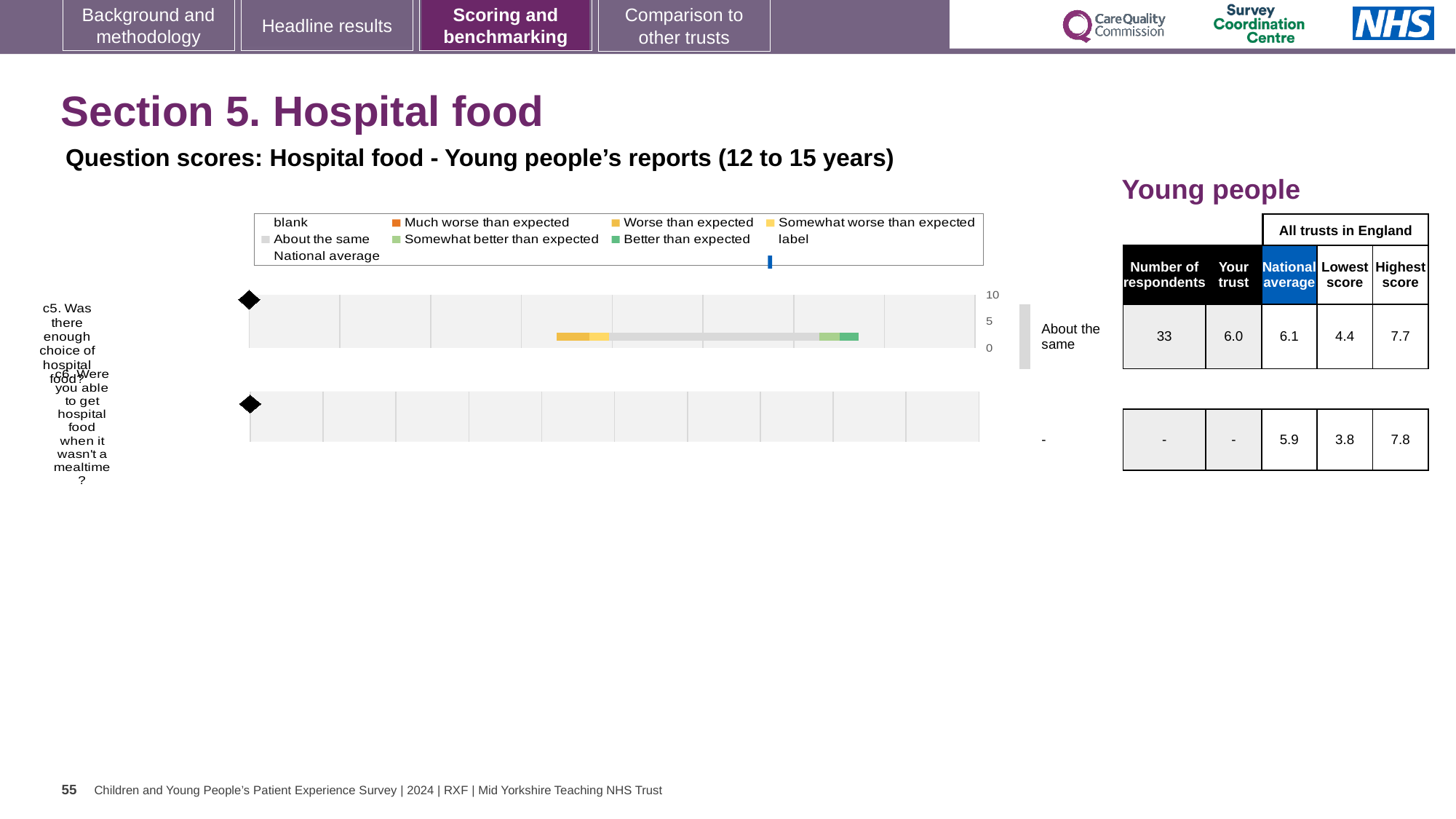
What benchmark category is shown next to the chart for question c5? About the same In the table beside the chart, what is the 'Your trust' score for question c5? 6.0 What is the label of the first question plotted on the chart? c5. Was there enough choice of hospital food? What kind of chart is shown on the slide? bar chart What is the highest value shown on the chart's numeric axis? 10 In the table beside the chart, what is the national average for question c5? 6.1 In the table beside the chart, what is the national average for question c6? 5.9 In the table beside the chart, which is larger for question c5: the 'Your trust' score or the national average? national average In the table beside the chart, what is the difference between the highest score and the lowest score for question c5? 3.3 Which colour in the legend represents 'Much worse than expected'? orange How many survey questions (categories) are plotted on the chart? 2 In the table beside the chart, how many respondents answered question c5? 33